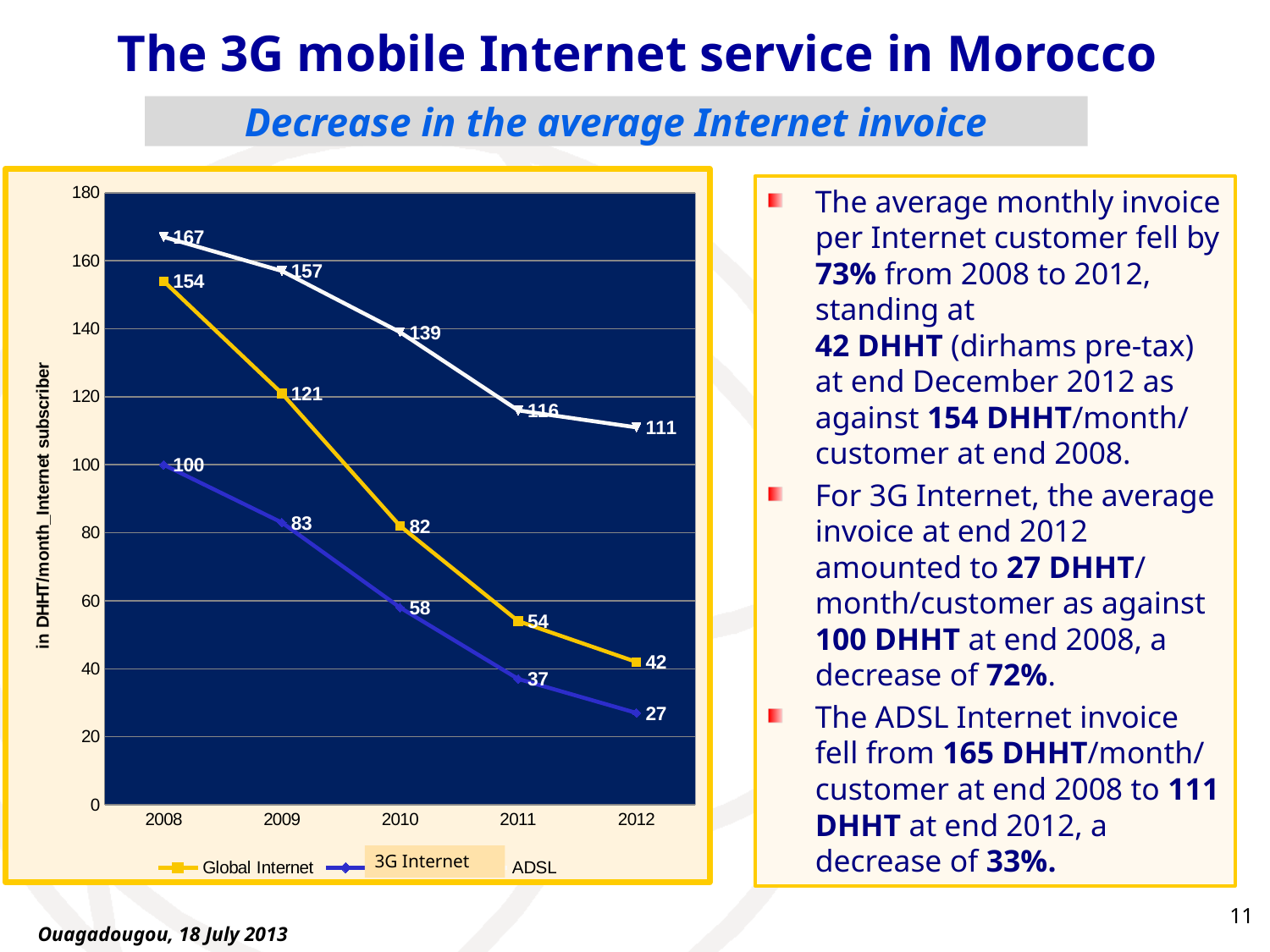
How many years are shown on the x axis? 5 What is the difference between the ADSL value and the 3G Internet value in 2011? 79 How many series does the legend list? 3 Which year has the lowest Global Internet value? 2012 Which is larger in 2009, the Global Internet value or the 3G Internet value? Global Internet What is the Global Internet value for 2008? 154 Is the ADSL value for 2012 greater or less than 100? greater Which year has the highest ADSL value? 2008 What is the ADSL value for 2010? 139 What is the 3G Internet value for 2012? 27 What kind of chart is shown? line chart Do the 3G Internet values rise or fall from 2008 to 2012? fall